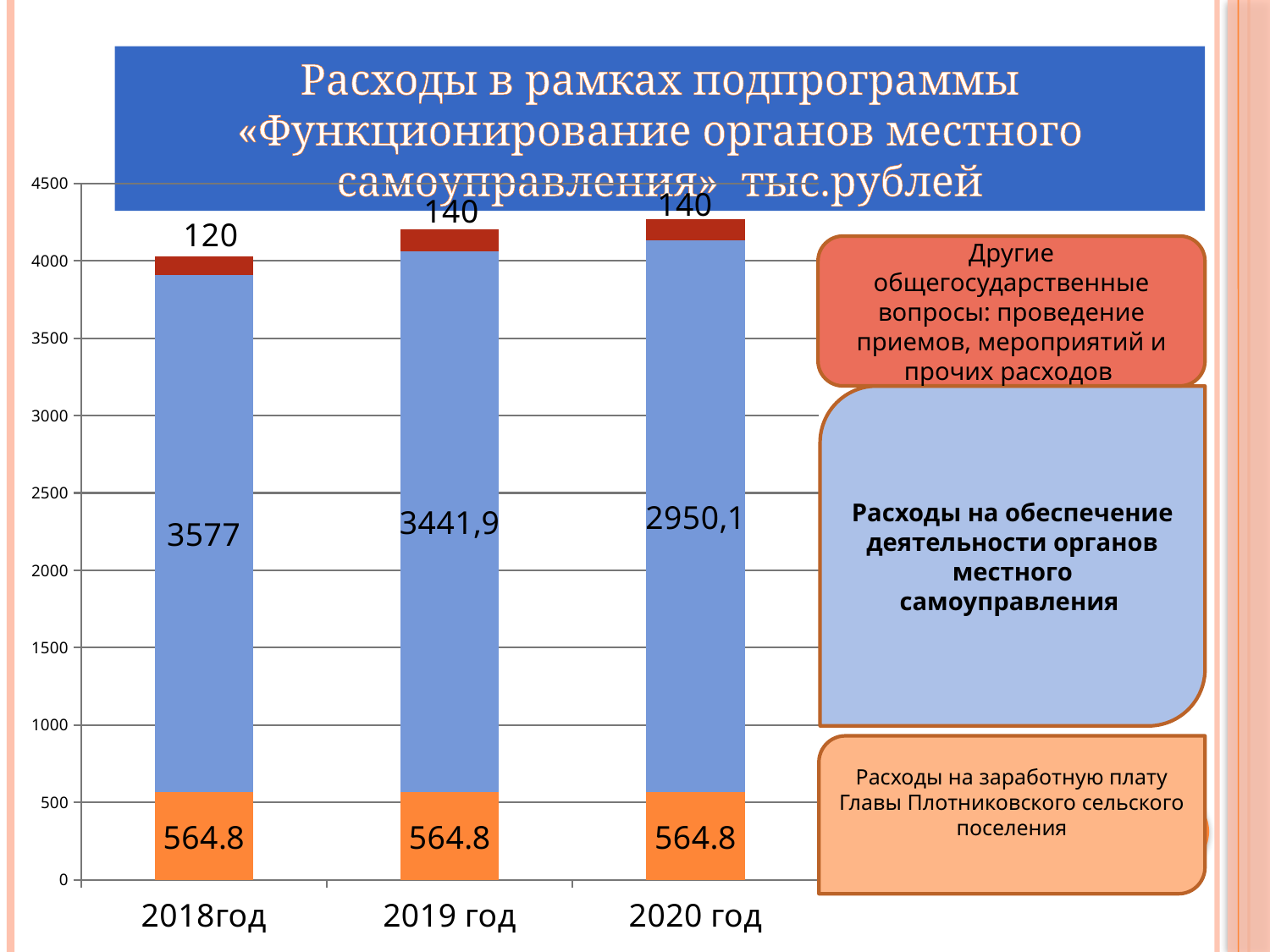
What is the value of the red top segment (Другие общегосударственные вопросы) for 2019 год? 140 What is the value of the blue segment (Расходы на обеспечение деятельности органов местного самоуправления) for 2018год? 3577 In which year is the red top segment (Другие общегосударственные вопросы) the smallest? 2018год What is the value of the blue segment for 2020 год? 2950,1 What is the value of the orange segment (Расходы на заработную плату Главы) for 2018год? 564.8 Is the total height of the 2020 год bar greater or less than 4000? greater What kind of chart is shown on the slide? stacked bar chart How many years (categories) are shown on the x axis? 3